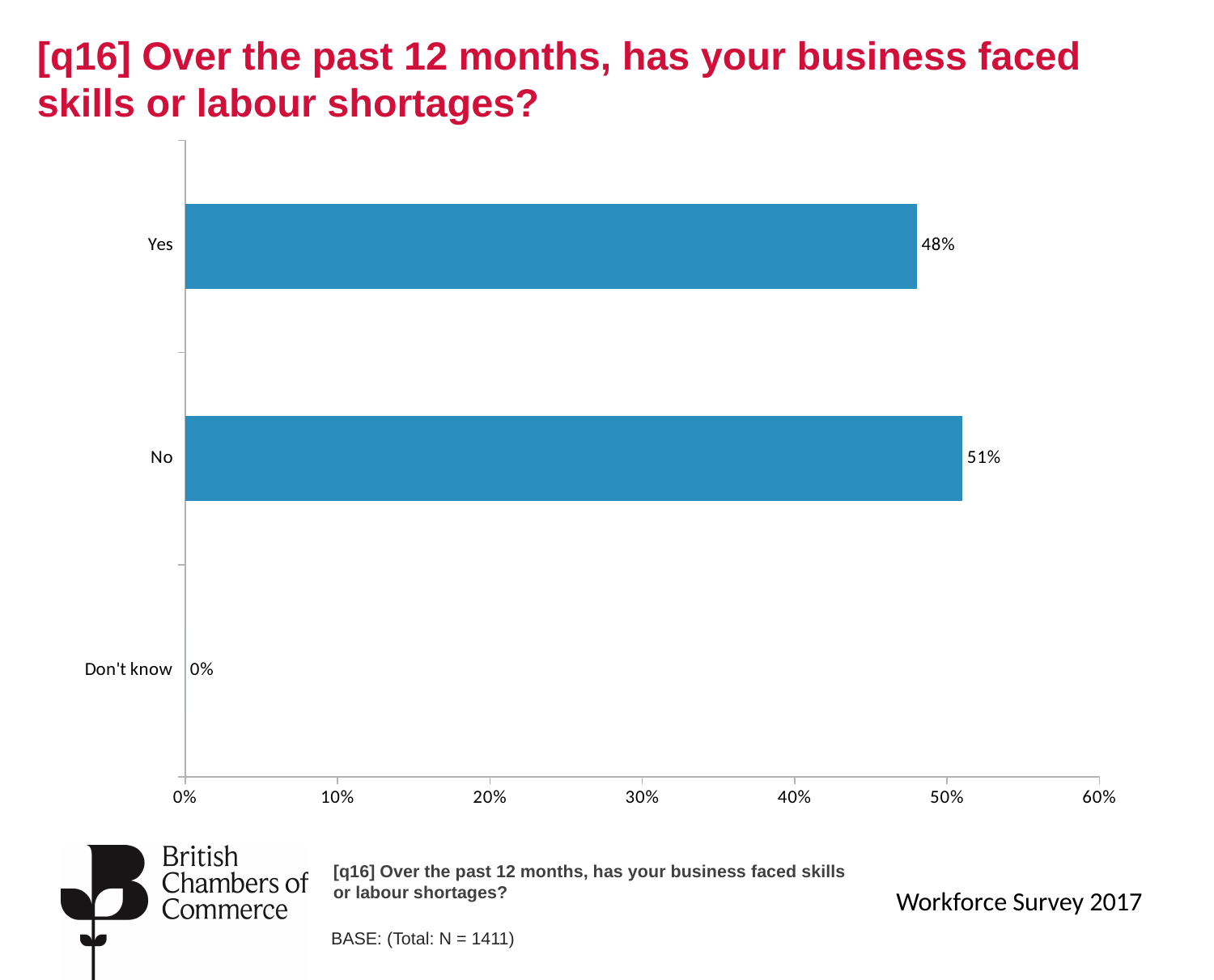
How many response categories are shown on the chart? 3 What is the difference between the "No" and "Yes" percentages? 3% What is the base sample size stated on the slide? N = 1411 Which is larger, the value for "Yes" or the value for "No"? No What percentage of businesses answered "Yes" to facing skills or labour shortages? 48% Is the value for "No" greater or less than 60%? less Is the value for "Yes" greater or less than 40%? greater What is the value shown for "Don't know"? 0% Which response category has the lowest value? Don't know What percentage of businesses answered "No"? 51% What type of chart is shown on the slide? Bar chart Which response category has the highest value? No